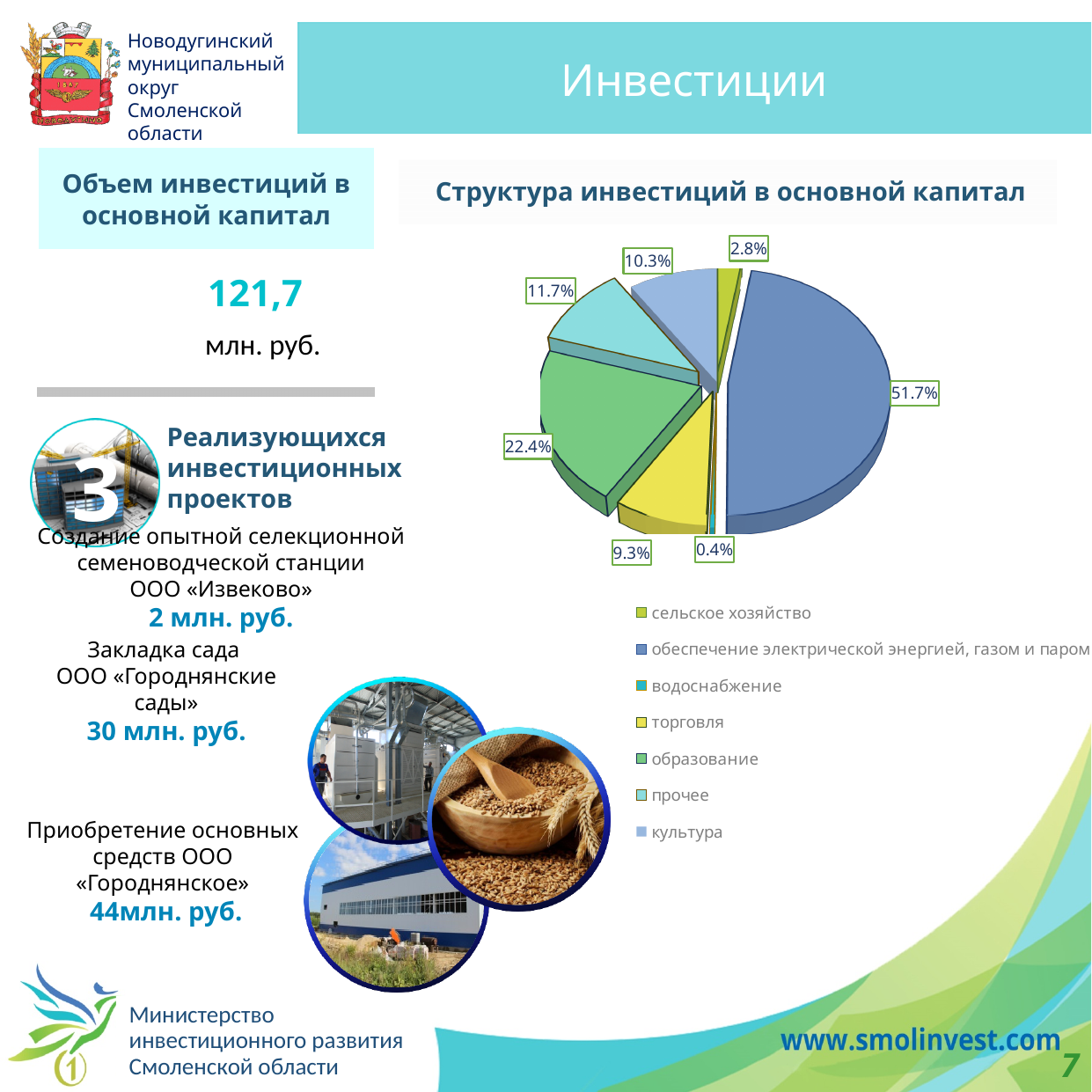
What kind of chart is shown under the title «Структура инвестиций в основной капитал»? pie chart In the pie chart «Структура инвестиций в основной капитал», what share does «культура» have? 10.3% How many categories does the legend of the pie chart «Структура инвестиций в основной капитал» list? 7 Which category has the largest slice in the pie chart «Структура инвестиций в основной капитал»? обеспечение электрической энергией, газом и паром In the pie chart «Структура инвестиций в основной капитал», which is larger: «прочее» or «культура»? прочее In the pie chart «Структура инвестиций в основной капитал», what colour is the slice for «образование»? green In the pie chart «Структура инвестиций в основной капитал», what share does «торговля» have? 9.3% In the pie chart «Структура инвестиций в основной капитал», what share does «образование» have? 22.4% Which category has the smallest slice in the pie chart «Структура инвестиций в основной капитал»? водоснабжение In the pie chart «Структура инвестиций в основной капитал», what share does «сельское хозяйство» have? 2.8% In the pie chart «Структура инвестиций в основной капитал», what is the difference between the shares of «образование» and «прочее»? 10.7% In the pie chart «Структура инвестиций в основной капитал», what share does «обеспечение электрической энергией, газом и паром» have? 51.7%